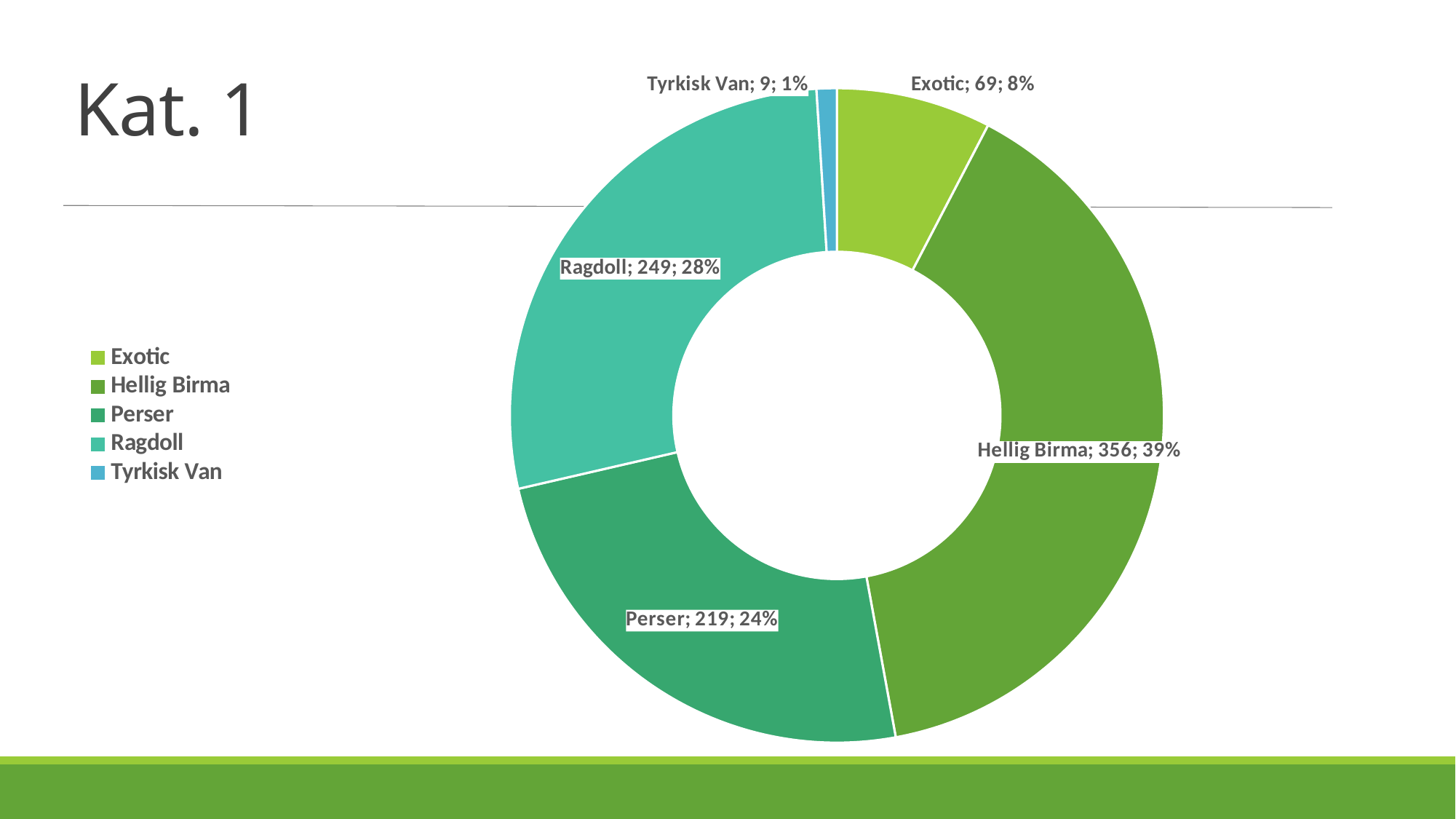
What is the value for Ragdoll? 249 What is the value for Tyrkisk Van? 9 Which is larger, the value for Perser or the value for Exotic? Perser What percentage share does Perser have? 24% What percentage share does Exotic have? 8% What is the value for Hellig Birma? 356 What is the title of the slide? Kat. 1 What is the difference between the values for Hellig Birma and Ragdoll? 107 Which category has the lowest value? Tyrkisk Van How many categories are shown in the chart? 5 What kind of chart is shown on the slide? Doughnut chart Which category has the highest value? Hellig Birma